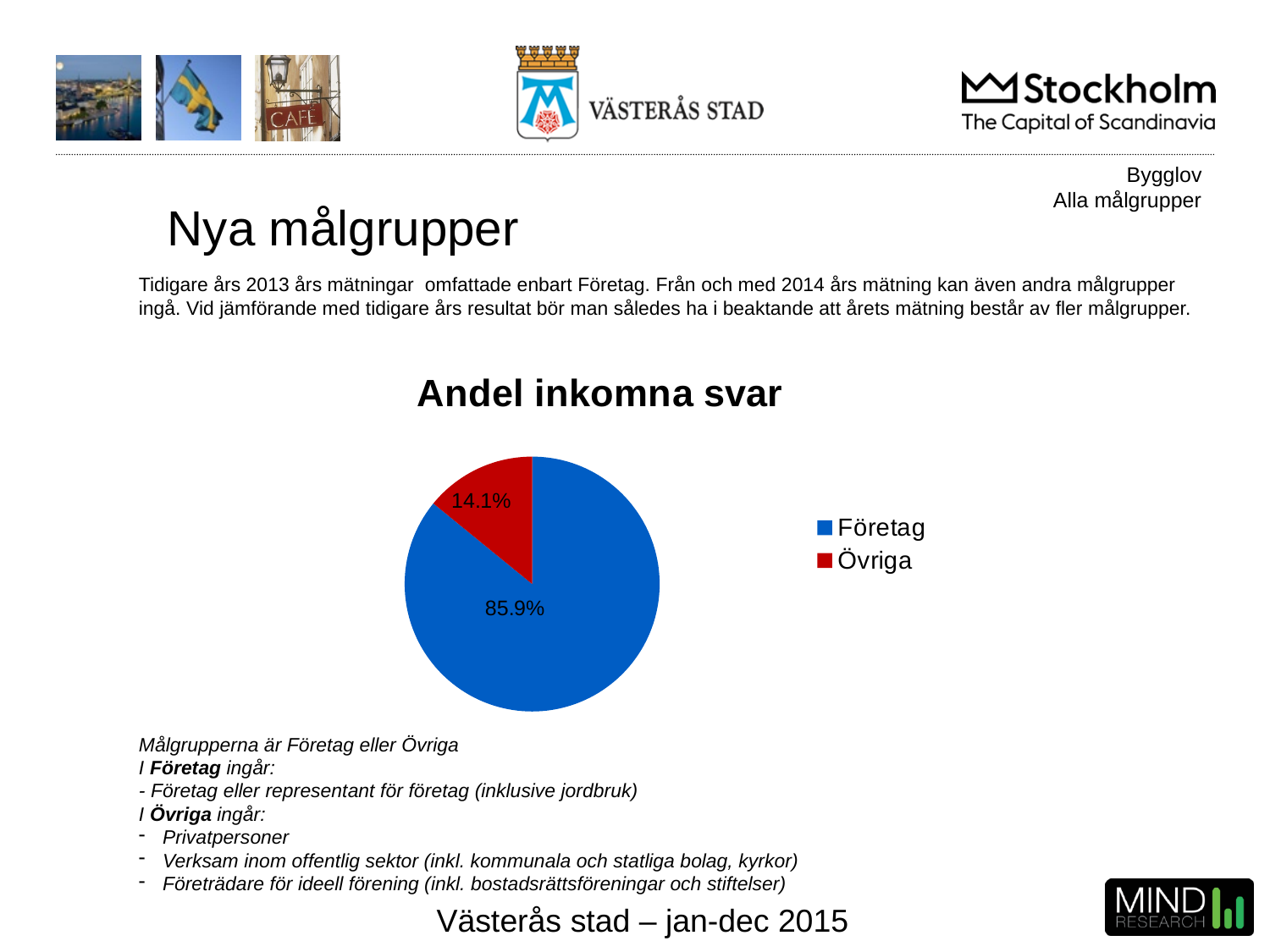
What is the difference in percentage points between the Företag and Övriga slices? 71.8 What colour is the Övriga slice in the pie chart? red How many slices does the pie chart have? 2 Which is larger, the Företag slice or the Övriga slice? Företag Which category has the largest slice of the pie? Företag What share of the pie does Övriga account for? 14.1% What share of the pie does Företag account for? 85.9% What is the title of the pie chart? Andel inkomna svar Which category has the smallest slice of the pie? Övriga How many entries does the legend list? 2 Is the share for Övriga greater or less than 50%? less What kind of chart is shown under the title "Andel inkomna svar"? pie chart